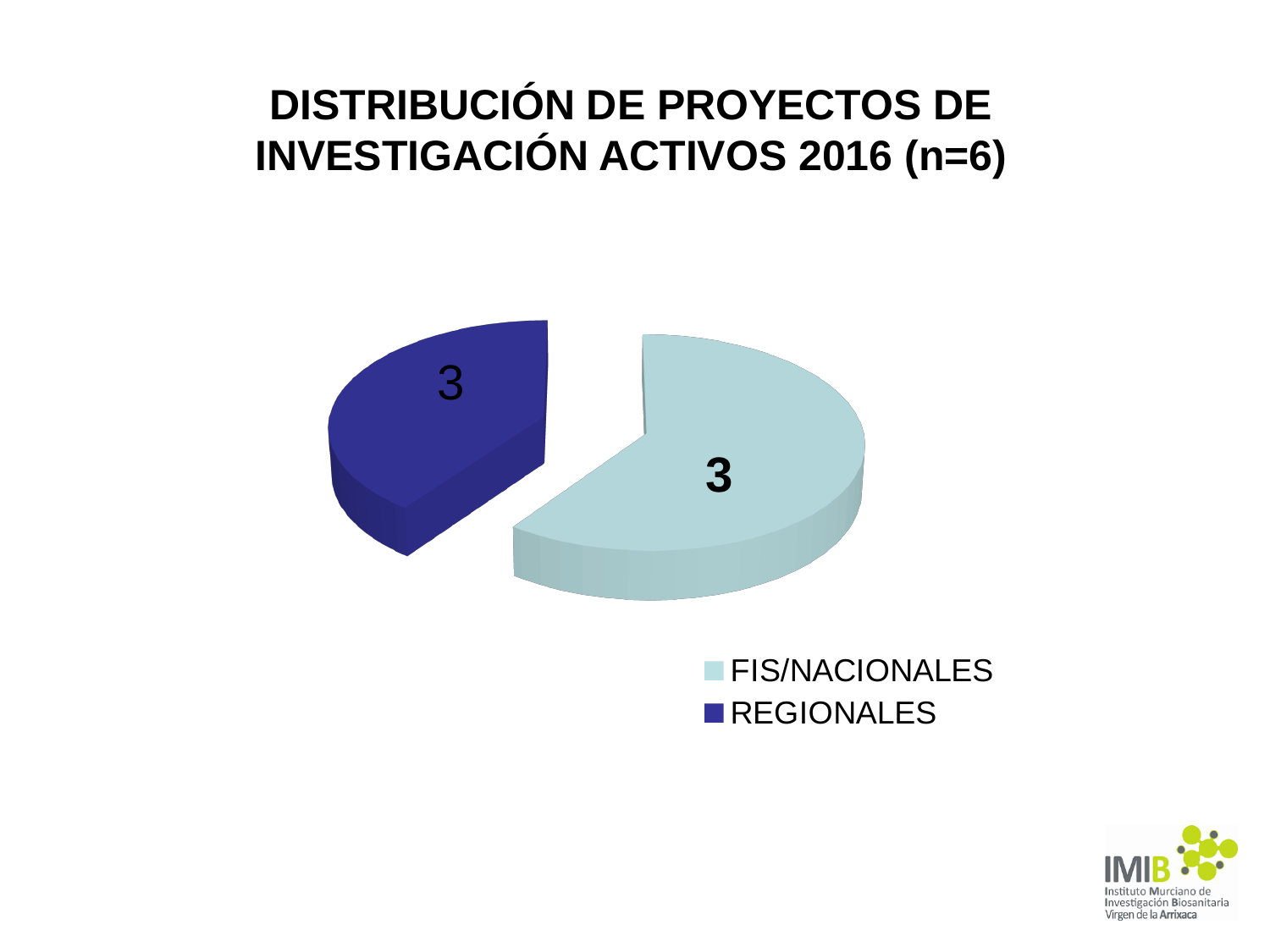
What share of the pie does the REGIONALES slice represent? 50% What is the value for FIS/NACIONALES? 3 What is the value for REGIONALES? 3 Which category is shown in dark blue in the legend? REGIONALES How many entries does the legend list? 2 How many categories does the pie chart have? 2 What kind of chart is shown on the slide? pie chart What is the total of all slices in the pie chart? 6 What share of the pie does the FIS/NACIONALES slice represent? 50% What is the title of the chart? DISTRIBUCIÓN DE PROYECTOS DE INVESTIGACIÓN ACTIVOS 2016 (n=6) What is the difference between the values for FIS/NACIONALES and REGIONALES? 0